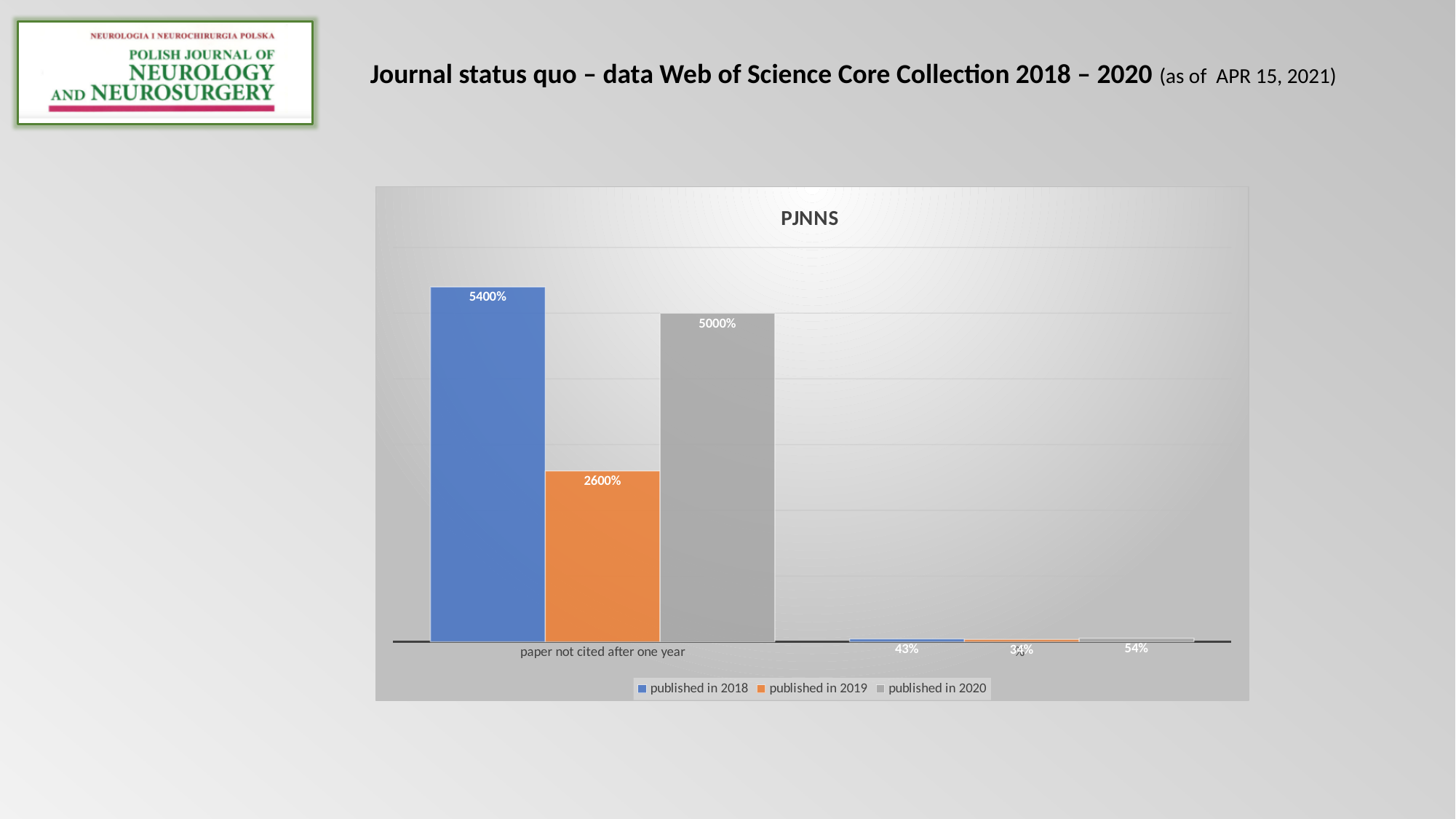
What is the title of the chart on the slide? PJNNS What kind of chart is shown on the slide? bar chart In the PJNNS chart, which series has the lowest value for 'paper not cited after one year'? published in 2019 How many series does the legend of the PJNNS chart list? 3 In the PJNNS chart, which series has the highest value for 'paper not cited after one year'? published in 2018 How many groups of bars are plotted in the PJNNS chart? 2 In the PJNNS chart, for 'paper not cited after one year', which is larger: 'published in 2020' or 'published in 2019'? published in 2020 In the PJNNS chart, what is the value for 'published in 2019' in the 'paper not cited after one year' category? 2600% In the PJNNS chart, what is the value for 'published in 2018' in the 'paper not cited after one year' category? 5400% In the PJNNS chart, what is the difference between the 'published in 2018' and 'published in 2019' values for 'paper not cited after one year'? 2800% In the PJNNS chart, what is the difference between the 'published in 2018' and 'published in 2020' values for 'paper not cited after one year'? 400% In the PJNNS chart, what is the value for 'published in 2020' in the 'paper not cited after one year' category? 5000%